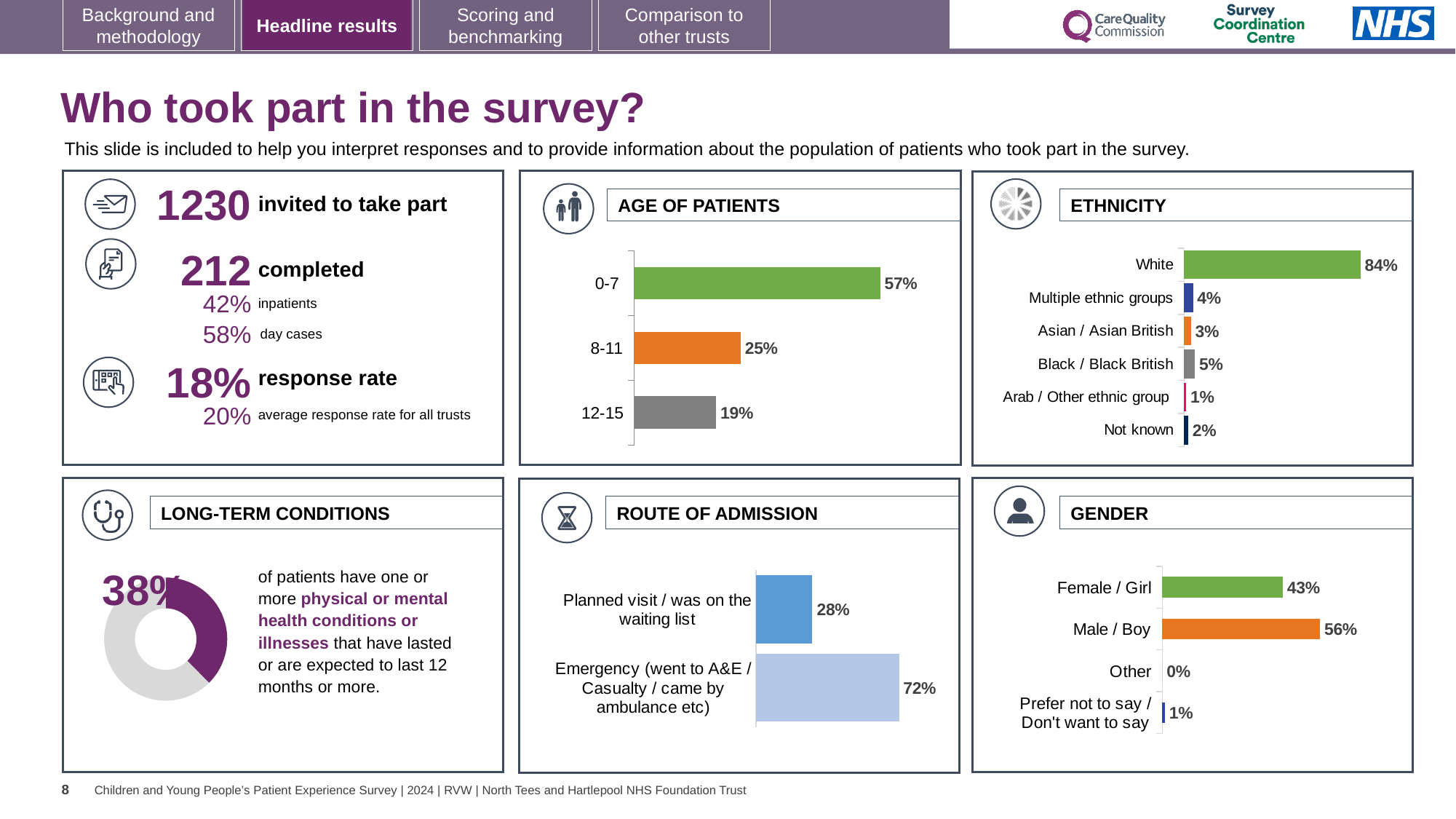
In the AGE OF PATIENTS chart, which age group has the lowest percentage? 12-15 In the GENDER chart, which category has the highest percentage? Male / Boy In the ROUTE OF ADMISSION chart, what is the difference between the Emergency and Planned visit percentages? 44% In the ROUTE OF ADMISSION chart, what percentage of patients came via Emergency? 72% In the GENDER chart, what percentage of patients were Male / Boy? 56% In the AGE OF PATIENTS chart, what percentage of patients were aged 0-7? 57% In the ETHNICITY chart, what percentage of patients were White? 84% What kind of chart is used in the LONG-TERM CONDITIONS panel? Doughnut chart In the AGE OF PATIENTS chart, what is the difference between the 0-7 and 8-11 percentages? 32% In the ETHNICITY chart, which is larger: Black / Black British or Asian / Asian British? Black / Black British How many ethnicity categories are shown in the ETHNICITY chart? 6 In the ETHNICITY chart, which category has the lowest percentage? Arab / Other ethnic group